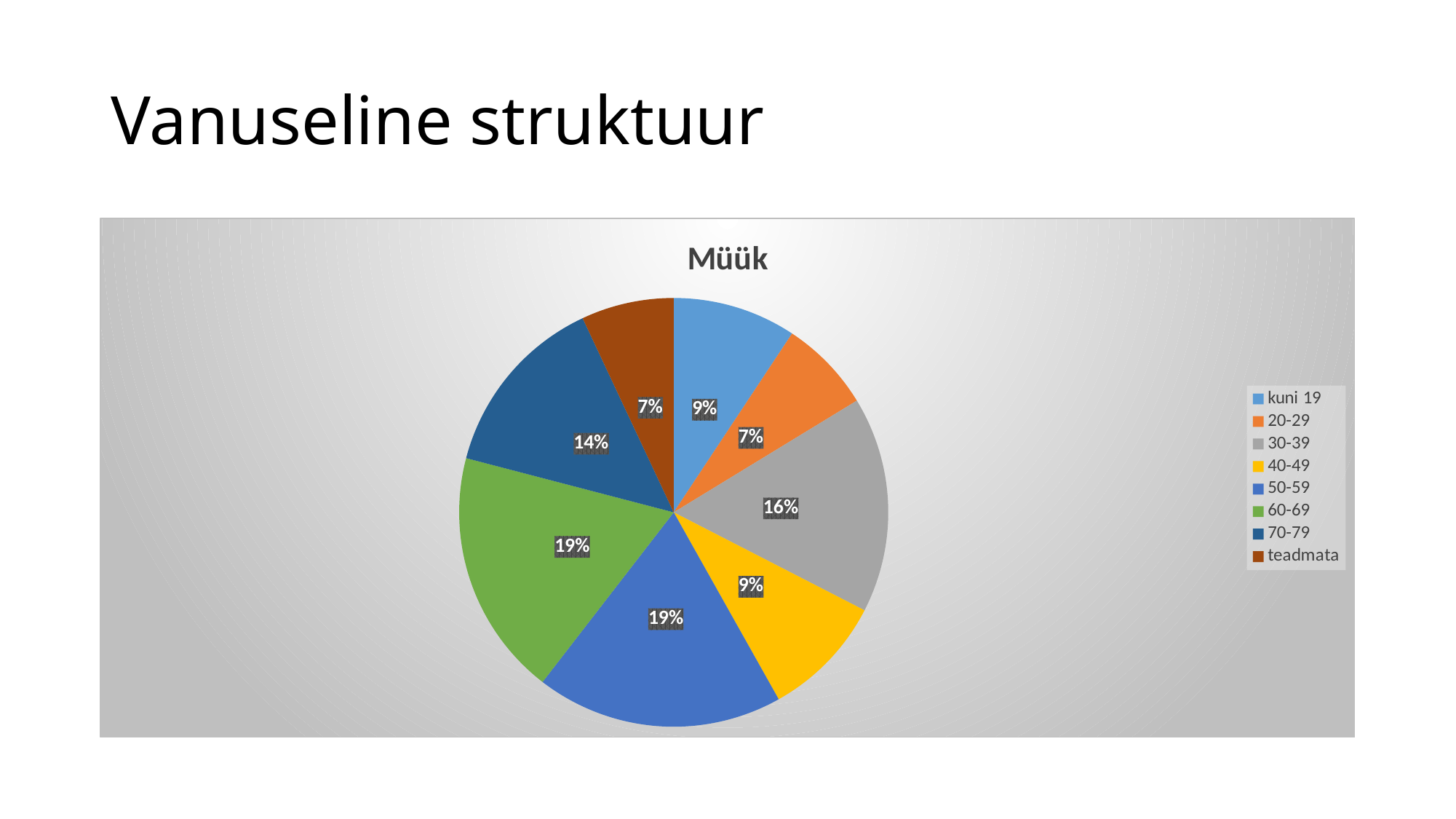
What is the title of the chart? Müük Which is larger, the 30-39 slice or the 40-49 slice? 30-39 What percentage is shown for the kuni 19 slice? 9% What is the difference in percentage points between the 30-39 slice and the kuni 19 slice? 7 What kind of chart is shown on the slide? pie chart What percentage is shown for the 50-59 category? 19% What is the difference in percentage points between the 60-69 slice and the 70-79 slice? 5 Which is larger, the 70-79 slice or the 20-29 slice? 70-79 What is the value shown for the teadmata slice? 7% What is the value shown for the 70-79 slice? 14% What share of the pie does the 30-39 category have? 16% How many slices does the pie chart have? 8